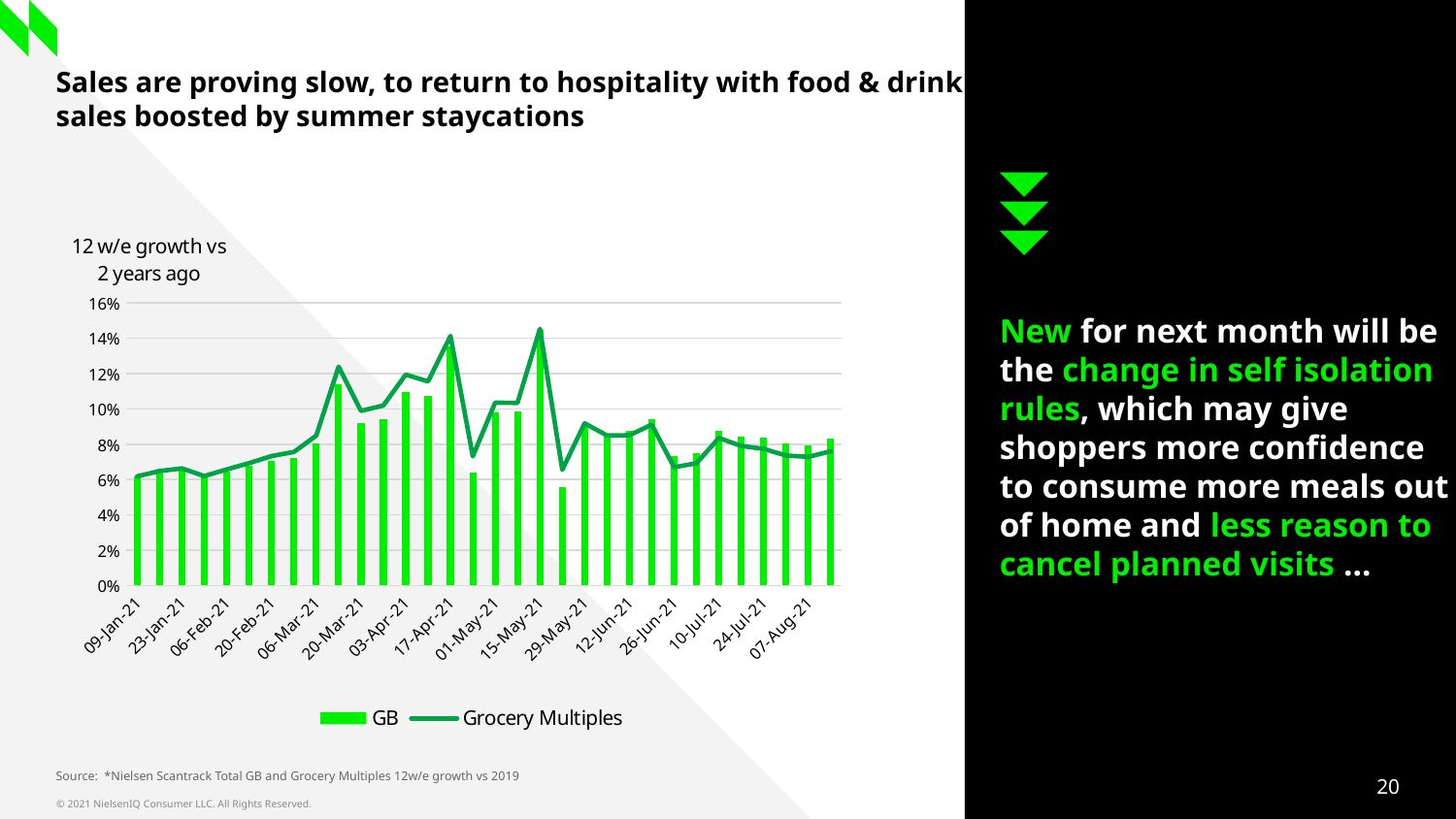
Which is higher for GB: the bar for 15-May-21 or the bar for 29-May-21? 15-May-21 What kind of chart is shown on the slide? A combination bar and line chart Is the GB value for 15-May-21 greater or less than 12%? greater Is the GB value for 09-Jan-21 greater or less than 8%? less Which is higher for GB: the bar for 20-Mar-21 or the bar for 06-Mar-21? 20-Mar-21 Does the GB value rise or fall from 15-May-21 to 29-May-21? fall How many series does the chart legend list? 2 Which two series are listed in the chart legend? GB and Grocery Multiples Is the Grocery Multiples value for 17-Apr-21 greater or less than 12%? greater What is the title of the chart? 12 w/e growth vs 2 years ago